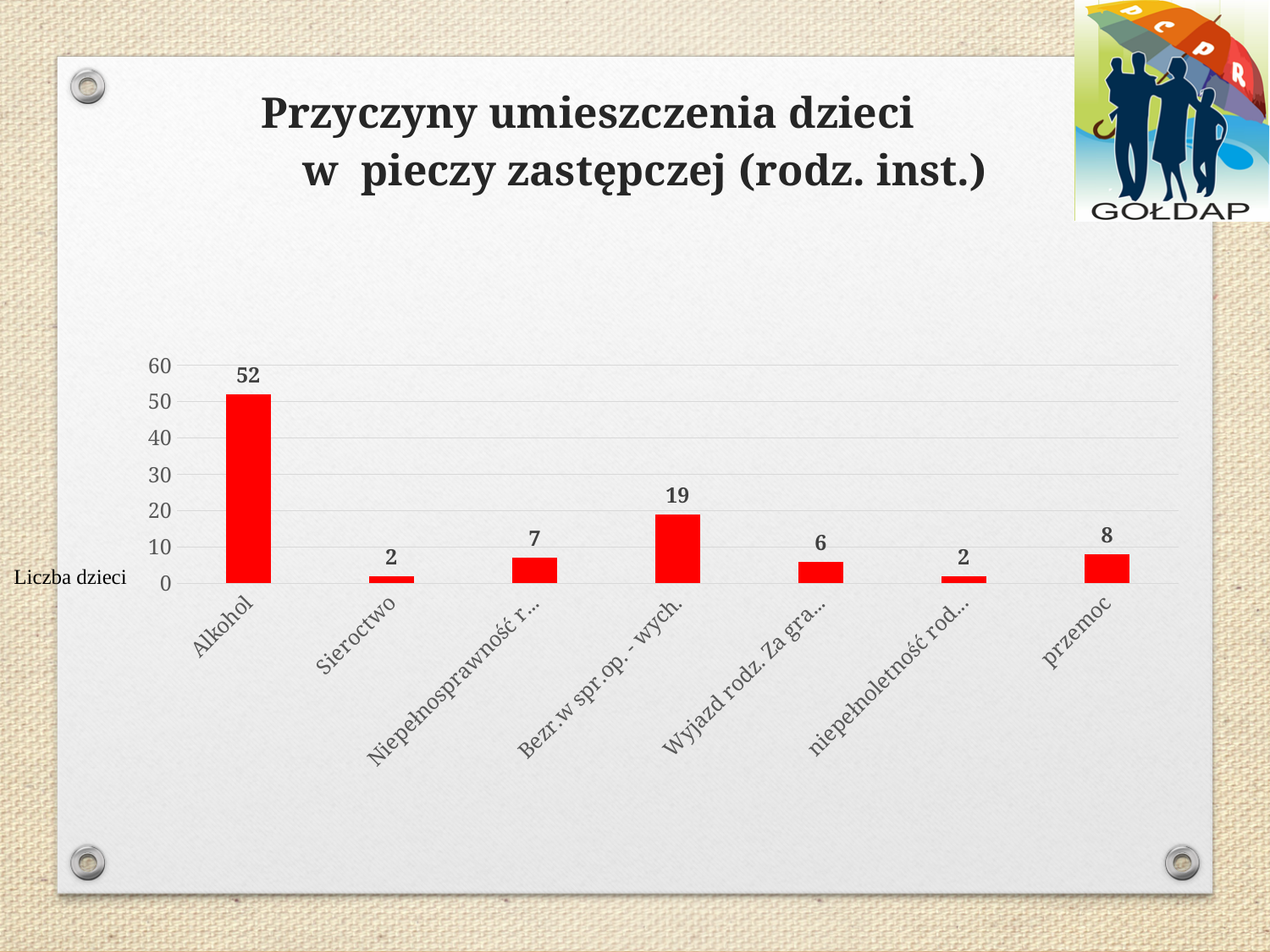
What type of chart is shown on the slide? bar chart What is the difference between the values for Alkohol and Bezr.w spr.op.- wych.? 33 Which is larger, the value for przemoc or the value for Sieroctwo? przemoc How many categories are shown in the chart? 7 What is the label of the vertical axis? Liczba dzieci What is the value for Sieroctwo? 2 What is the lowest value shown in the chart? 2 What is the value for przemoc? 8 What is the value for Bezr.w spr.op.- wych.? 19 Is the value for Alkohol greater or less than 50? greater What is the value for Alkohol? 52 Which category has the highest value? Alkohol